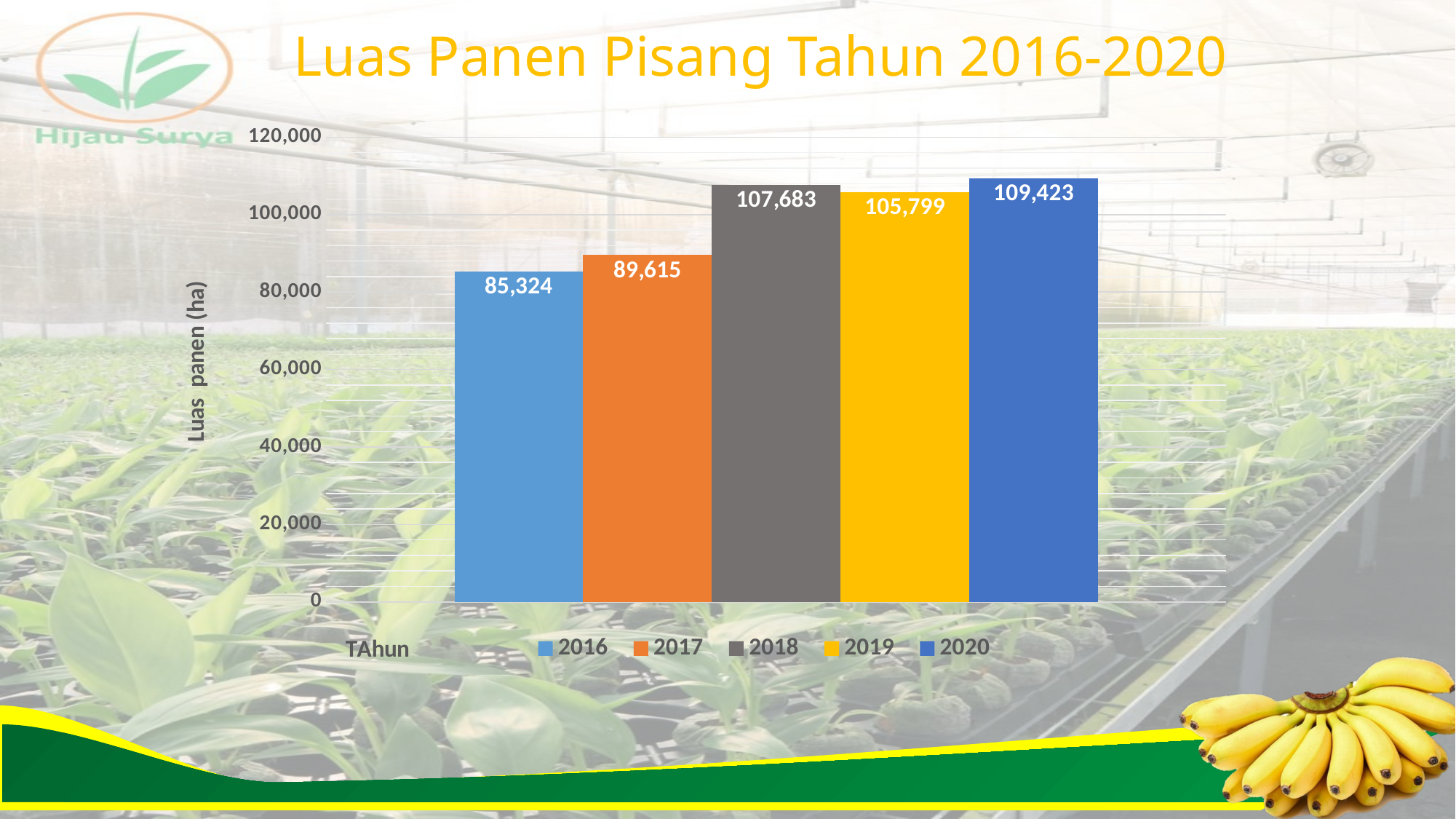
Which is larger, the value for 2018 or the value for 2019? 2018 Which year has the lowest value? 2016 What kind of chart is shown on the slide? bar chart What is the difference between the values for 2020 and 2016? 24,099 What is the difference between the values for 2018 and 2019? 1,884 Which year has the highest value? 2020 How many entries does the legend list? 5 What is the title of the chart? Luas Panen Pisang Tahun 2016-2020 How many bars are plotted in the chart? 5 What is the value for 2016? 85,324 What is the value for 2019? 105,799 Is the value for 2017 greater or less than 100,000? less